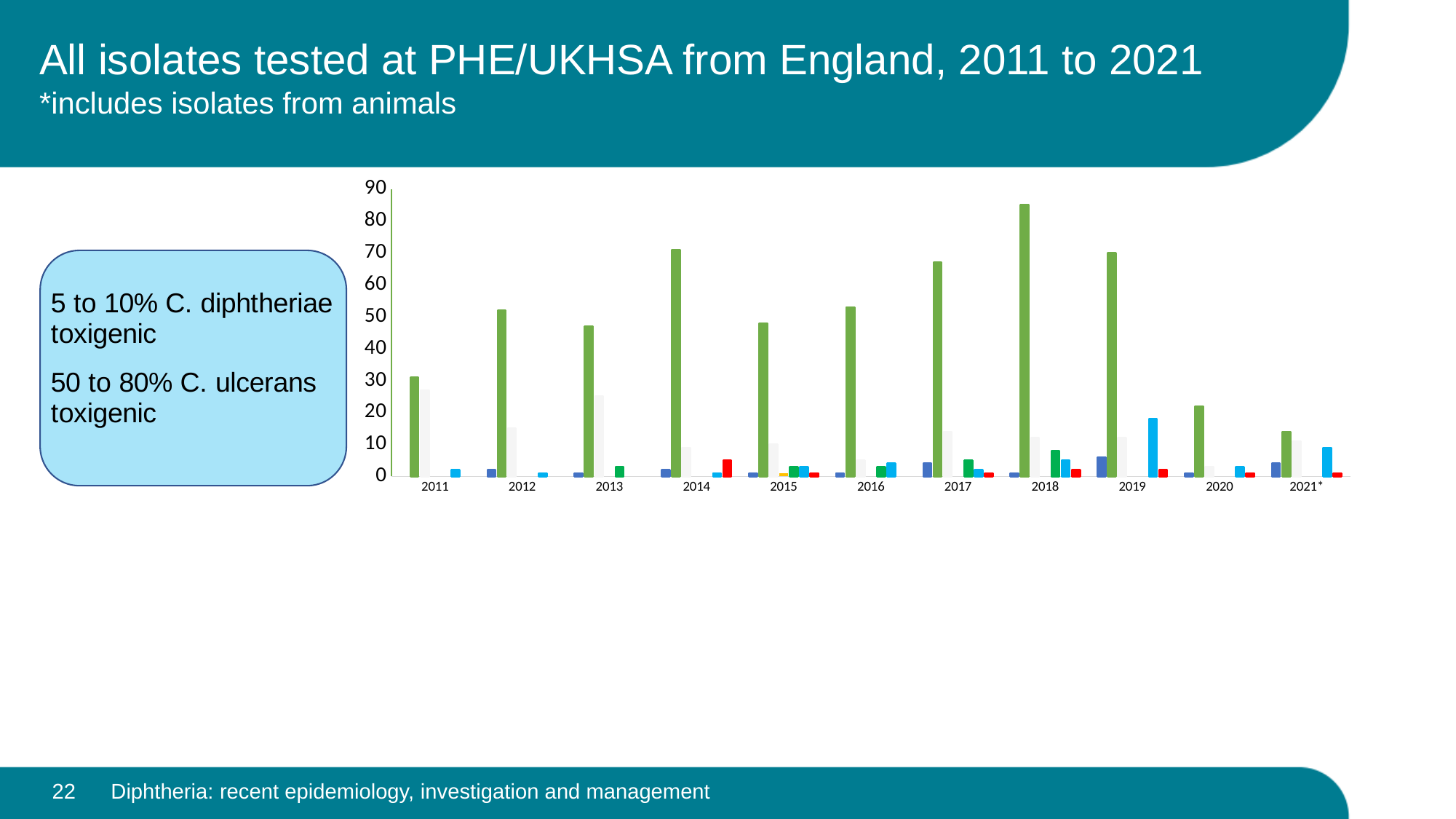
How many years are shown along the x axis of the chart? 11 In which year is the green bar the tallest? 2018 In which year is the green bar the shortest? 2021* Is the value of the green bar for 2011 greater or less than 40? less What is the title of the slide containing the chart? All isolates tested at PHE/UKHSA from England, 2011 to 2021 Is the value of the green bar for 2014 greater or less than 60? greater Do the green bars rise or fall from 2019 to 2021*? fall Which year has the taller light blue bar, 2011 or 2019? 2019 Which year has the taller green bar, 2013 or 2014? 2014 Is the value of the green bar for 2021* greater or less than 20? less What kind of chart is shown on the slide? bar chart